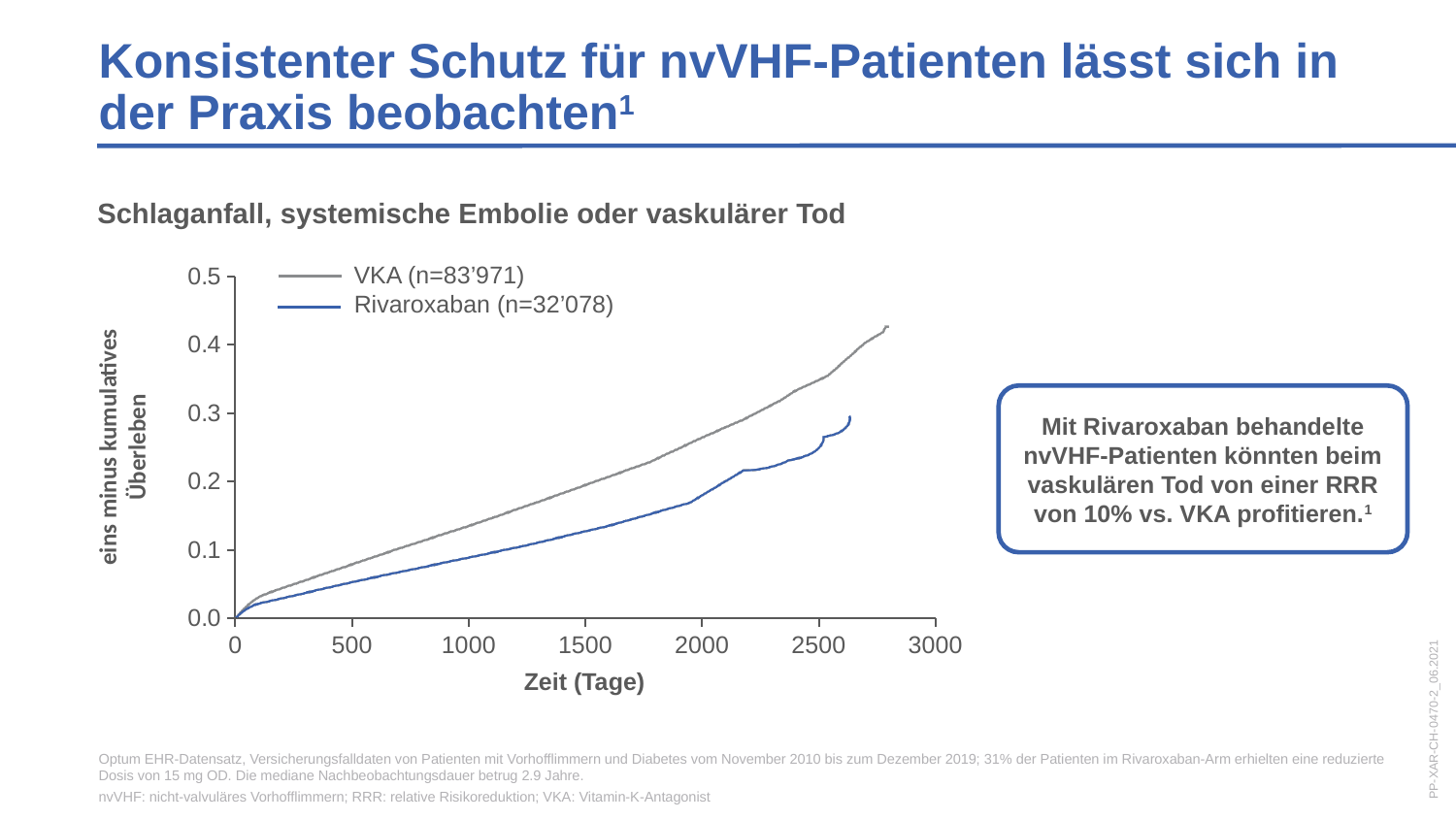
What is the label of the x axis of the chart? Zeit (Tage) Which two series are shown in the chart legend? VKA (n=83'971) and Rivaroxaban (n=32'078) What kind of chart is shown on the slide? Line chart Which series has the higher curve at 1500 days, VKA or Rivaroxaban? VKA Is the highest value reached by the VKA curve greater or less than 0.4? greater How many series does the chart legend list? 2 Is the value of the Rivaroxaban curve at 2000 days greater or less than 0.2? less Which series reaches the higher maximum value on the chart, VKA or Rivaroxaban? VKA Which series has the larger number of patients (n) according to the legend, VKA or Rivaroxaban? VKA Do the values of the VKA curve rise or fall as time increases along the x axis? Rise Is the value of the VKA curve at 2000 days greater or less than 0.2? greater